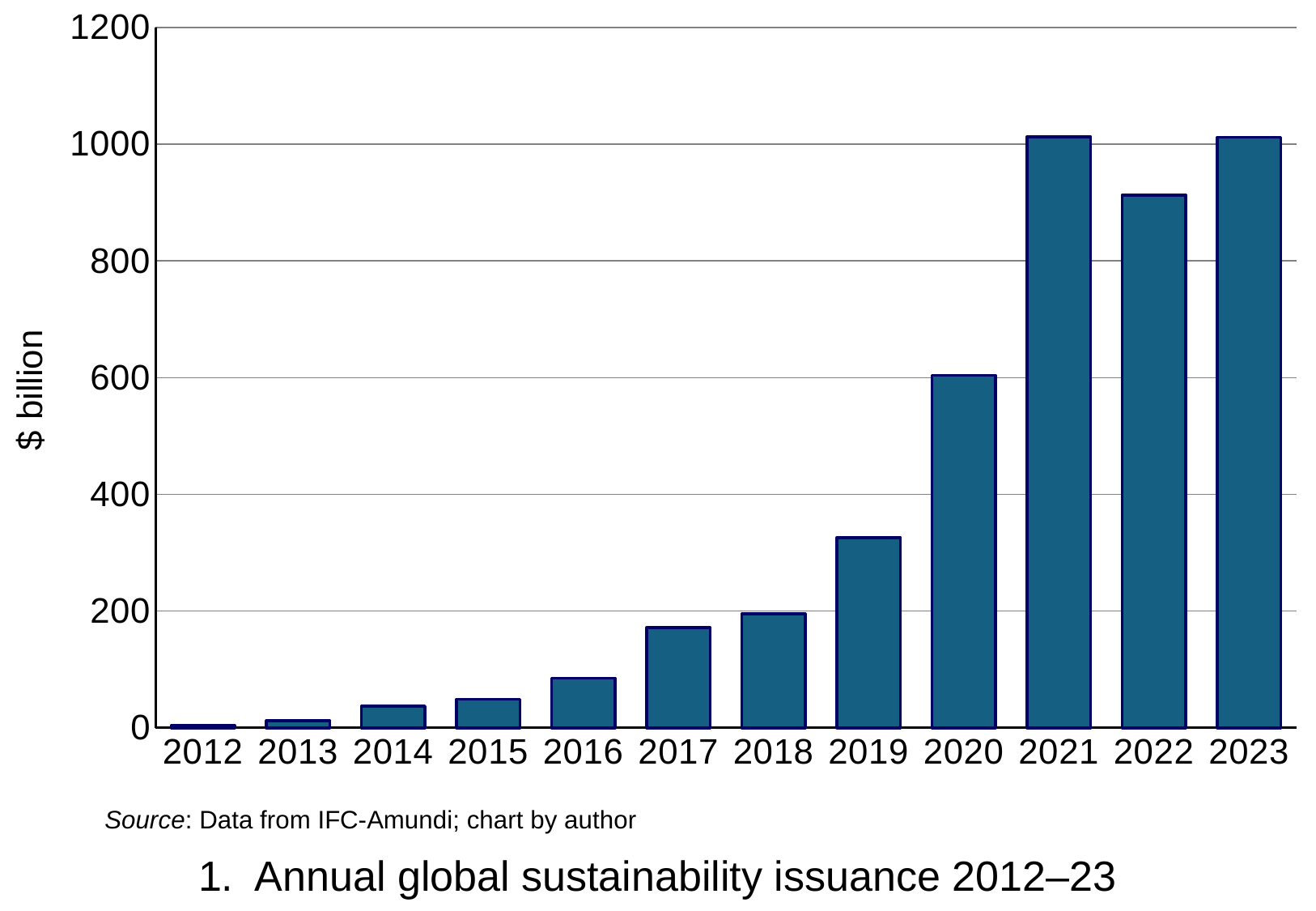
Do the values generally rise or fall from 2012 to 2021? rise Is the value for 2016 greater or less than 200? less Which year has the larger value, 2019 or 2020? 2020 Is the value for 2019 greater or less than 400? less What kind of chart is shown on the slide? bar chart Is the value for 2021 greater or less than 1000? greater How many years (bars) are plotted in the chart? 12 What is the label on the vertical axis of the chart? $ billion Which year has the larger value, 2021 or 2022? 2021 Which year has the lowest annual global sustainability issuance? 2012